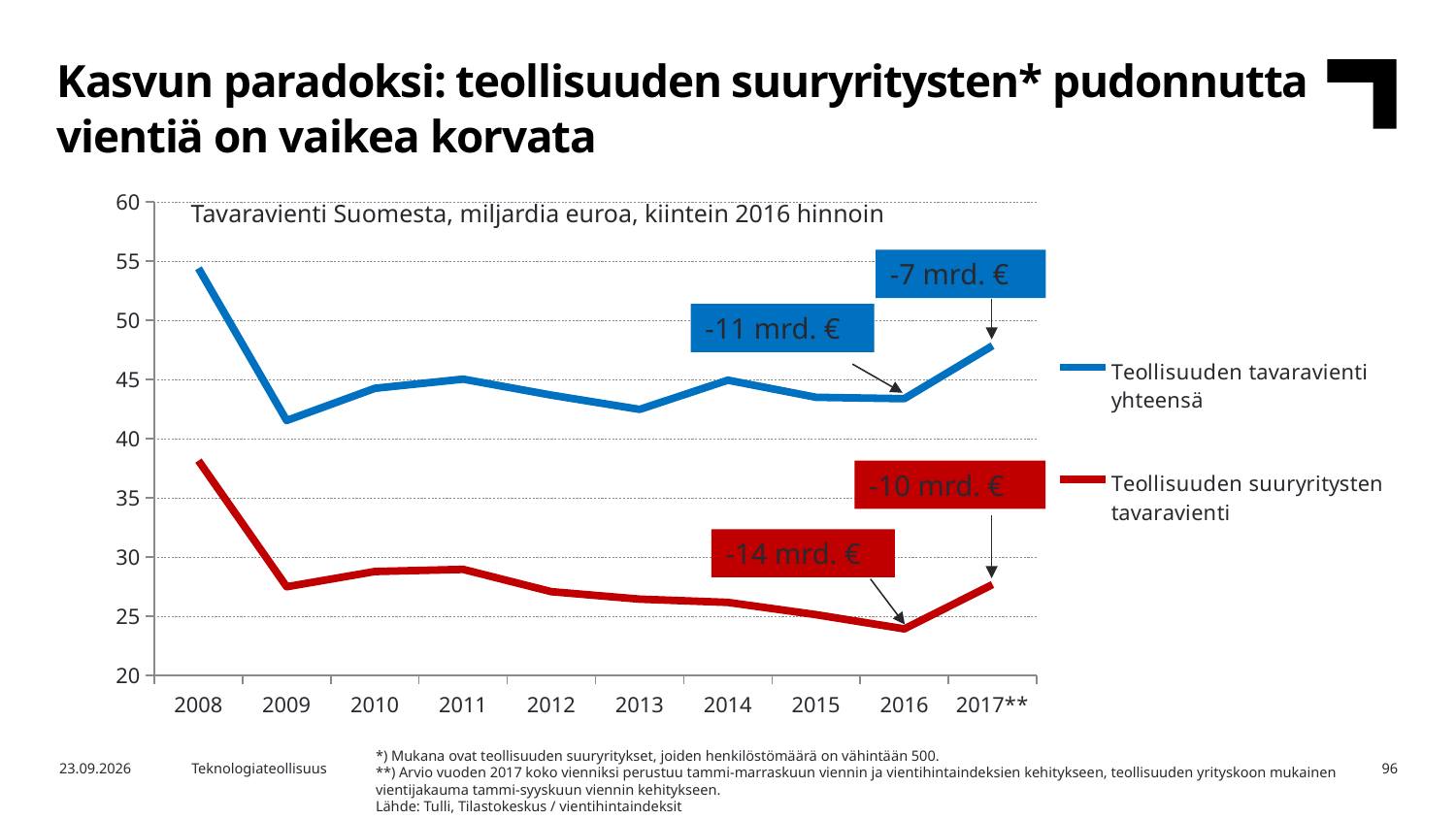
Is the value for 'Teollisuuden tavaravienti yhteensä' in 2016 greater or less than 45? less Which series has the larger value in 2008, 'Teollisuuden tavaravienti yhteensä' or 'Teollisuuden suuryritysten tavaravienti'? Teollisuuden tavaravienti yhteensä How many series does the legend list? 2 What is the title of the chart? Tavaravienti Suomesta, miljardia euroa, kiintein 2016 hinnoin In which year is the value for 'Teollisuuden suuryritysten tavaravienti' lowest? 2016 How many years are shown on the x axis? 10 Is the value for 'Teollisuuden suuryritysten tavaravienti' in 2016 greater or less than 25? less Is the value for 'Teollisuuden tavaravienti yhteensä' in 2008 greater or less than 50? greater Do the values for 'Teollisuuden suuryritysten tavaravienti' rise or fall from 2008 to 2009? fall What kind of chart is shown on the slide? line chart Which colour is used for the series 'Teollisuuden suuryritysten tavaravienti'? red In which year is the value for 'Teollisuuden tavaravienti yhteensä' highest? 2008